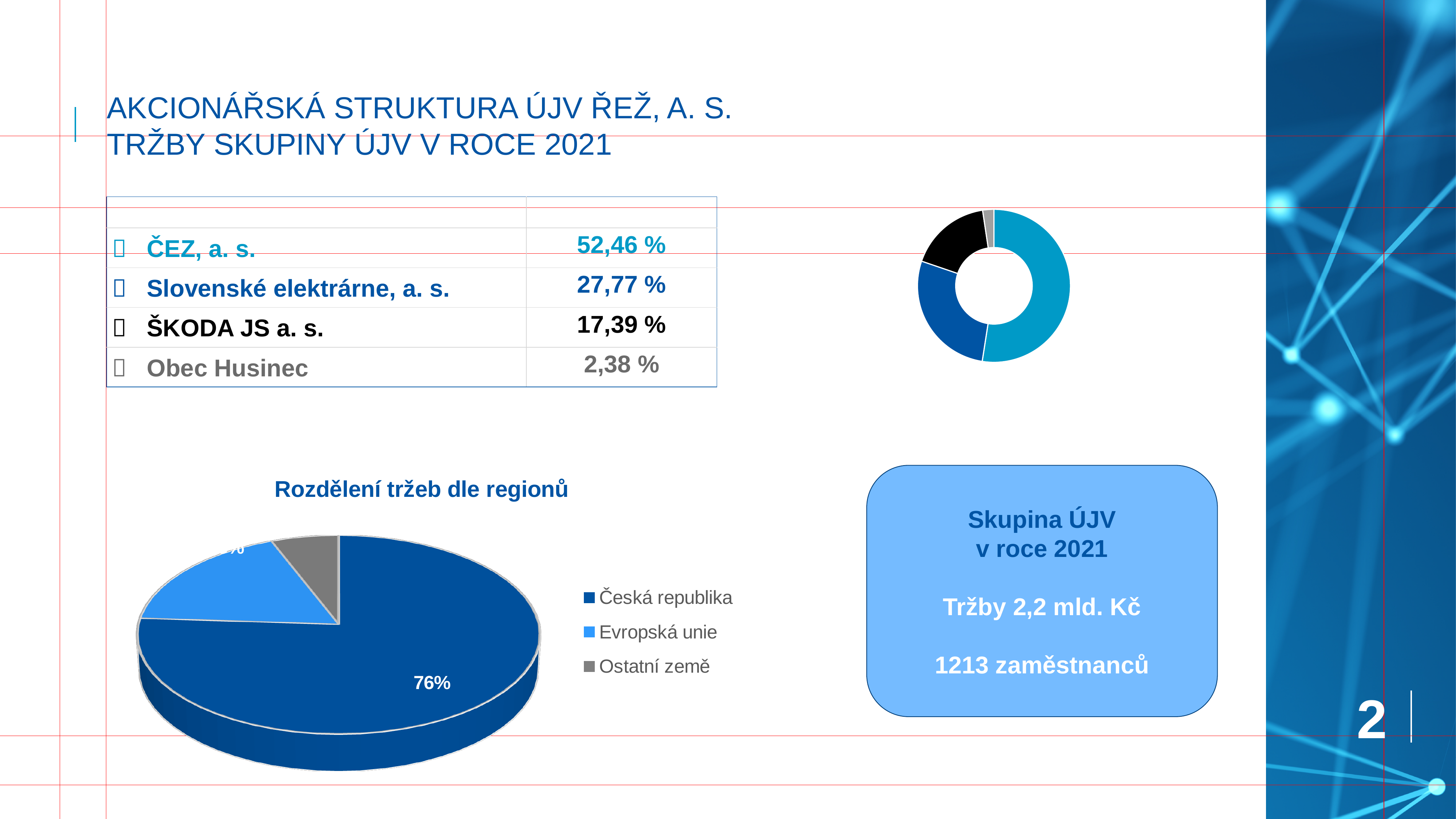
In the shareholder structure chart at the top right, which shareholder holds the smallest share? Obec Husinec How many shareholders are shown in the shareholder structure chart at the top right? 4 What type of chart is the shareholder structure chart at the top right of the slide? Doughnut chart In the shareholder structure chart at the top right, how much larger is the share of ČEZ, a. s. than that of Slovenské elektrárne, a. s.? 24,69 % In the 'Rozdělení tržeb dle regionů' pie chart, what share of revenue comes from Česká republika? 76% In the 'Rozdělení tržeb dle regionů' pie chart, which region has the smallest share? Ostatní země In the 'Rozdělení tržeb dle regionů' pie chart, which region has the largest share? Česká republika What type of chart is the 'Rozdělení tržeb dle regionů' chart at the bottom left of the slide? Pie chart How many regions does the legend of the 'Rozdělení tržeb dle regionů' pie chart list? 3 In the shareholder structure chart at the top right, what is the share held by ČEZ, a. s.? 52,46 % In the 'Rozdělení tržeb dle regionů' pie chart, which slice is larger: Evropská unie or Ostatní země? Evropská unie In the shareholder structure chart at the top right, what is the share held by Slovenské elektrárne, a. s.? 27,77 %